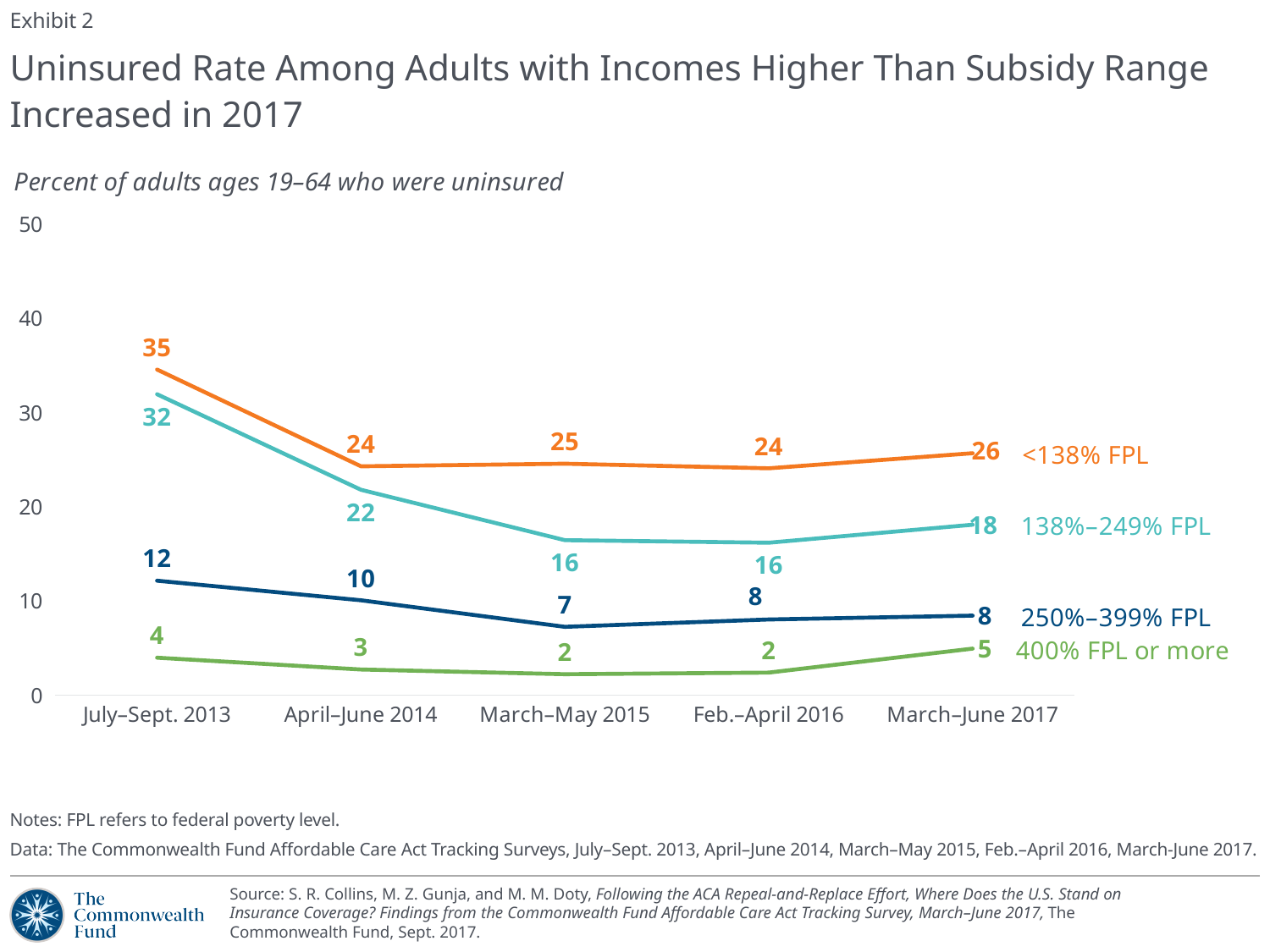
What was the uninsured rate for the 400% FPL or more group in March–May 2015? 2 What was the uninsured rate for adults with incomes <138% FPL in July–Sept. 2013? 35 Which income group had the highest uninsured rate in March–June 2017? <138% FPL How many income groups (lines) are plotted on the chart? 4 Which was larger in Feb.–April 2016: the uninsured rate for the 250%–399% FPL group or the 400% FPL or more group? 250%–399% FPL By how many points did the uninsured rate for the <138% FPL group fall from July–Sept. 2013 to April–June 2014? 11 What is the maximum value shown on the y axis? 50 How many survey periods are shown on the x axis? 5 What was the uninsured rate for the 138%–249% FPL group in March–June 2017? 18 What kind of chart is shown on the slide? Line chart Which income group had the lowest uninsured rate in July–Sept. 2013? 400% FPL or more Did the uninsured rate for the 400% FPL or more group rise or fall between Feb.–April 2016 and March–June 2017? Rise